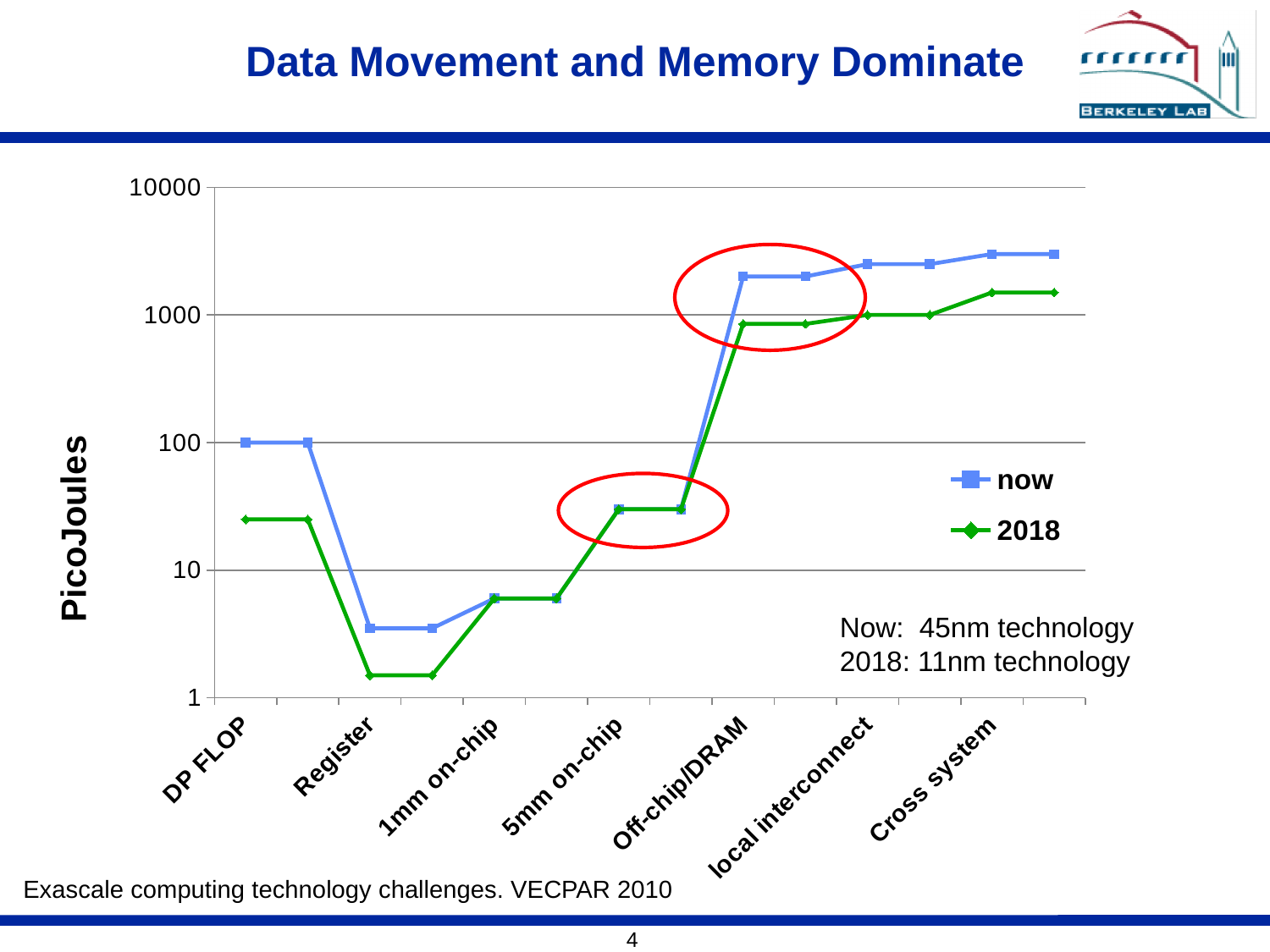
Is the value for Off-chip/DRAM in the 'now' series greater or less than 1000? greater How many series does the legend list? 2 Is the value for DP FLOP in the '2018' series greater or less than 100? less Which category has the lowest value in the 'now' series? Register For Off-chip/DRAM, which series has the larger value, 'now' or '2018'? now Which category has the highest value in the '2018' series? Cross system How many labelled categories are on the x axis? 7 What is the label on the y axis? PicoJoules Is the value for Off-chip/DRAM in the '2018' series greater or less than 1000? less What is the value for DP FLOP in the 'now' series? 100 What kind of chart is shown on the slide? line chart